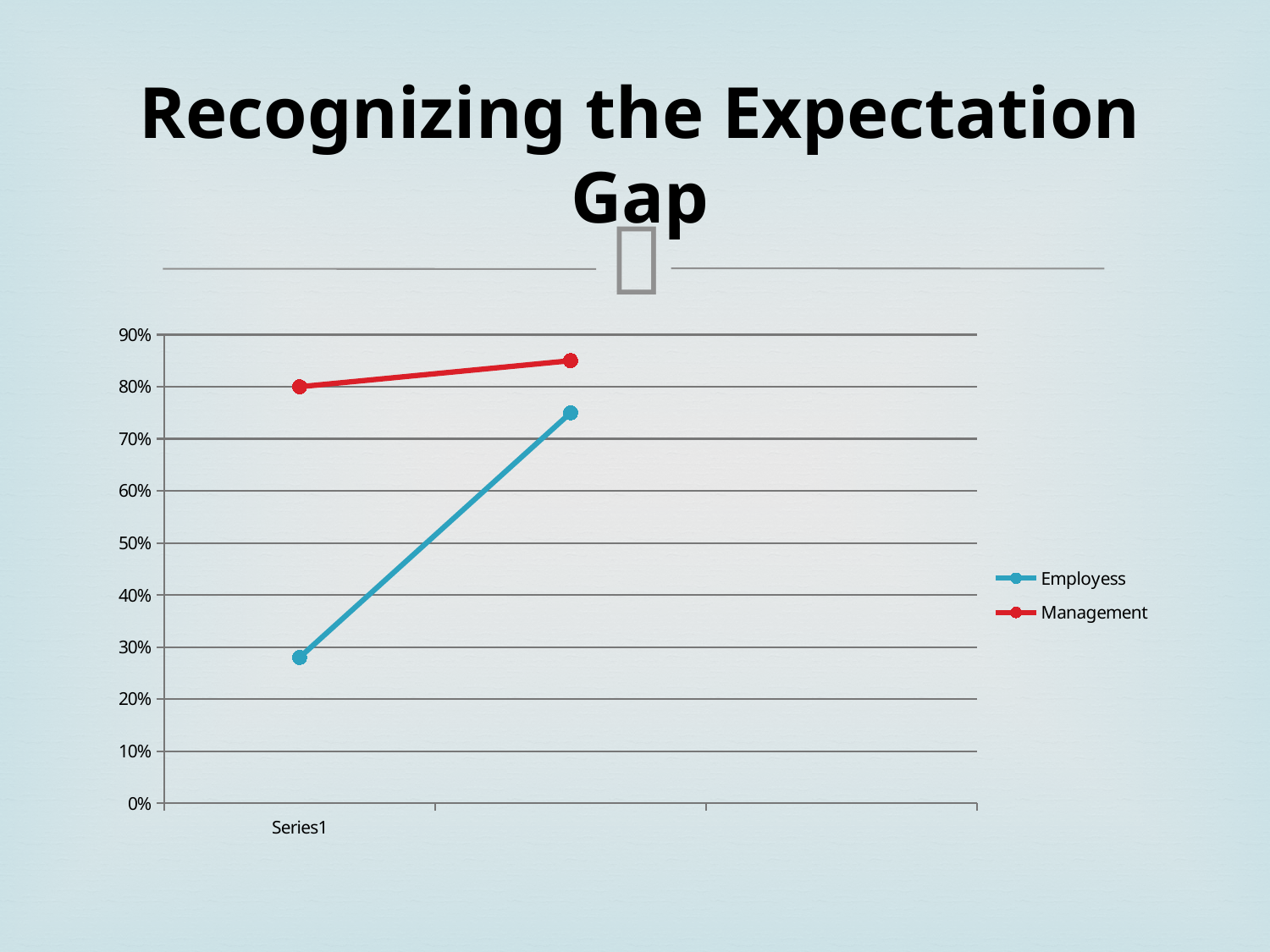
What is the value for Management at Series1? 80% What kind of chart is shown on the slide? line chart At Series1, which series has the higher value, Employess or Management? Management How many data points does the Employess line have? 2 Is the value for Employess at Series1 greater or less than 40%? less Is the second point of the Employess line greater or less than 70%? greater Is the second point of the Management line greater or less than 80%? greater How many series does the legend list? 2 Does the Employess line rise or fall from left to right? rise What colour is the Management line? red Does the Management line rise or fall from left to right? rise What are the two entries in the chart legend? Employess and Management